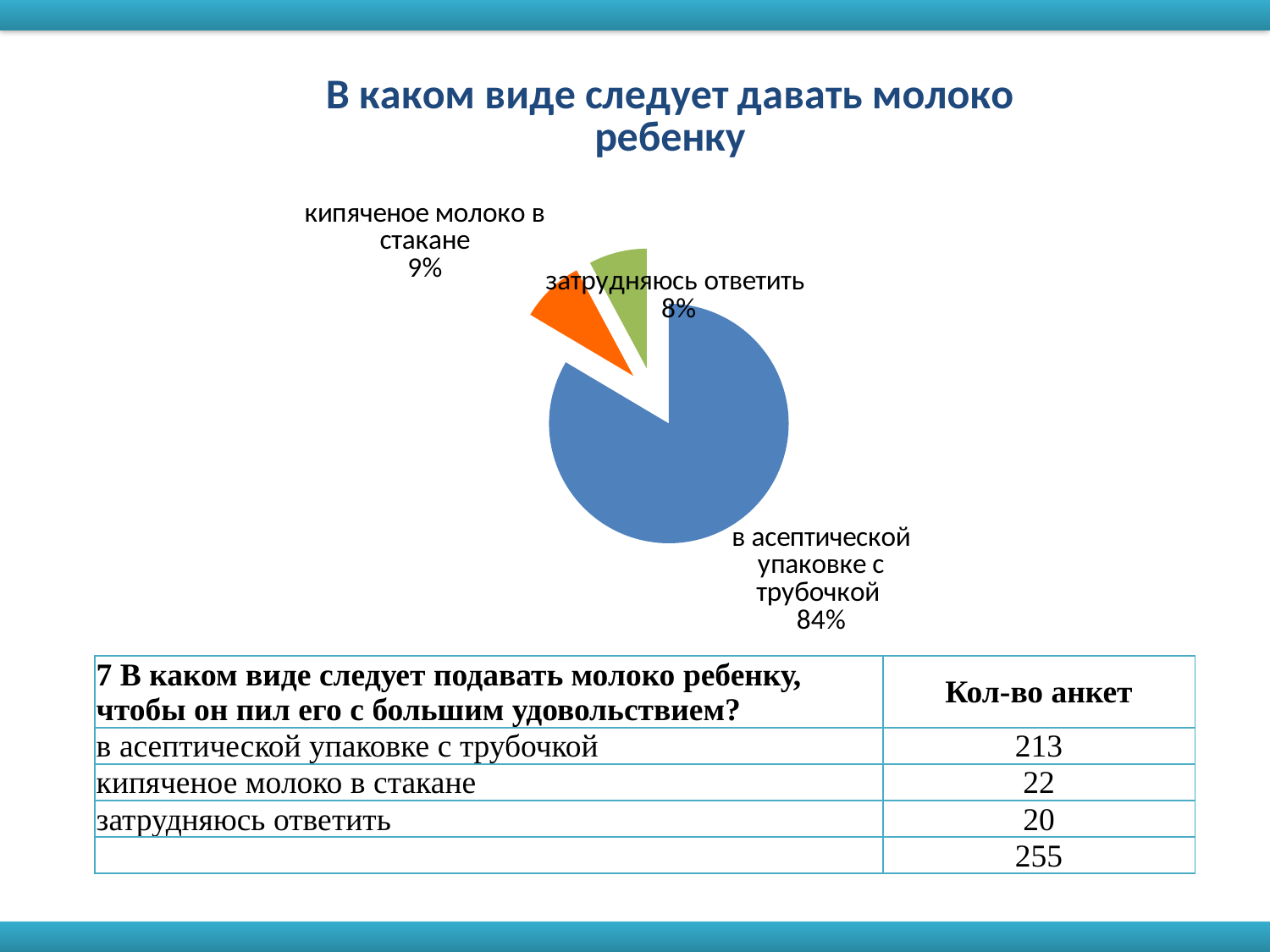
What is the title of the chart? В каком виде следует давать молоко ребенку Which is larger: the slice for "кипяченое молоко в стакане" or the slice for "затрудняюсь ответить"? кипяченое молоко в стакане What is the difference in percentage points between "кипяченое молоко в стакане" and "затрудняюсь ответить"? 1 What colour is the slice for "в асептической упаковке с трубочкой"? blue What share of the pie does "затрудняюсь ответить" have? 8% What share of the pie does "в асептической упаковке с трубочкой" have? 84% Which category has the largest slice of the pie? в асептической упаковке с трубочкой Which category has the smallest slice of the pie? затрудняюсь ответить What is the difference in percentage points between "в асептической упаковке с трубочкой" and "кипяченое молоко в стакане"? 75 What share of the pie does "кипяченое молоко в стакане" have? 9% What type of chart is shown on the slide? pie chart How many slices does the pie chart have? 3